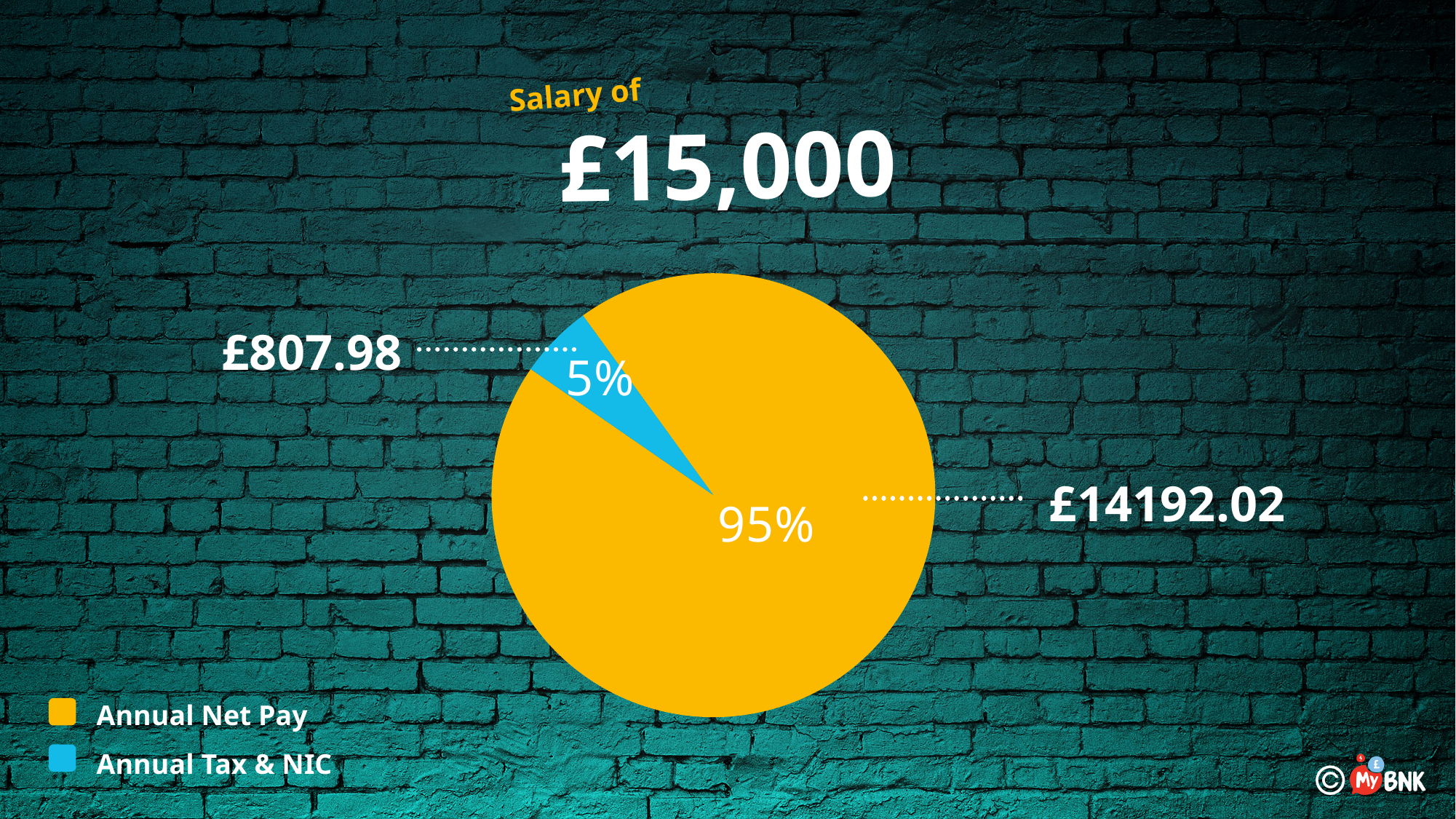
How many slices does the pie chart have? 2 What share of the pie is Annual Net Pay? 95% How many entries does the legend list? 2 What salary is the chart based on? £15,000 What kind of chart is shown on the slide? pie chart Which slice is the smallest? Annual Tax & NIC Which slice is the largest? Annual Net Pay Which is larger, Annual Net Pay or Annual Tax & NIC? Annual Net Pay What share of the pie is Annual Tax & NIC? 5% What is the value for Annual Net Pay? £14192.02 What is the value for Annual Tax & NIC? £807.98 What colour is the Annual Tax & NIC slice? blue